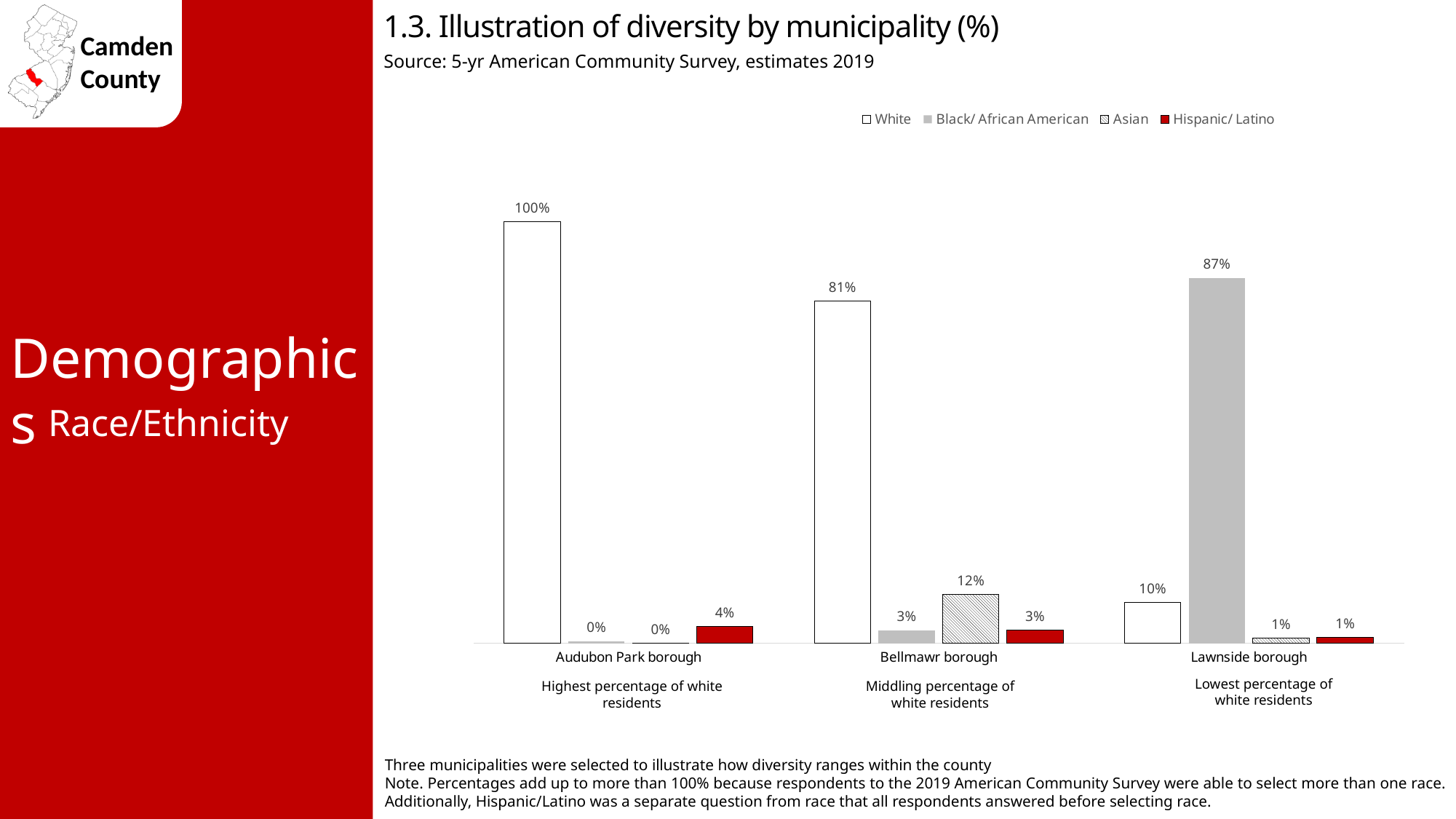
What is the Hispanic/ Latino percentage for Audubon Park borough? 4% What is the White percentage for Audubon Park borough? 100% How many series does the legend list? 4 What is the Asian percentage for Bellmawr borough? 12% How many municipalities are shown on the chart? 3 Which municipality has the lowest White percentage? Lawnside borough What is the Black/ African American percentage for Lawnside borough? 87% Which is larger: the Asian percentage for Bellmawr borough or the Hispanic/ Latino percentage for Bellmawr borough? Asian percentage for Bellmawr borough What is the source cited for the chart? 5-yr American Community Survey, estimates 2019 What is the difference between the White percentage for Audubon Park borough and Bellmawr borough? 19% What kind of chart is shown on the slide? Bar chart Which municipality has the highest Hispanic/ Latino percentage? Audubon Park borough